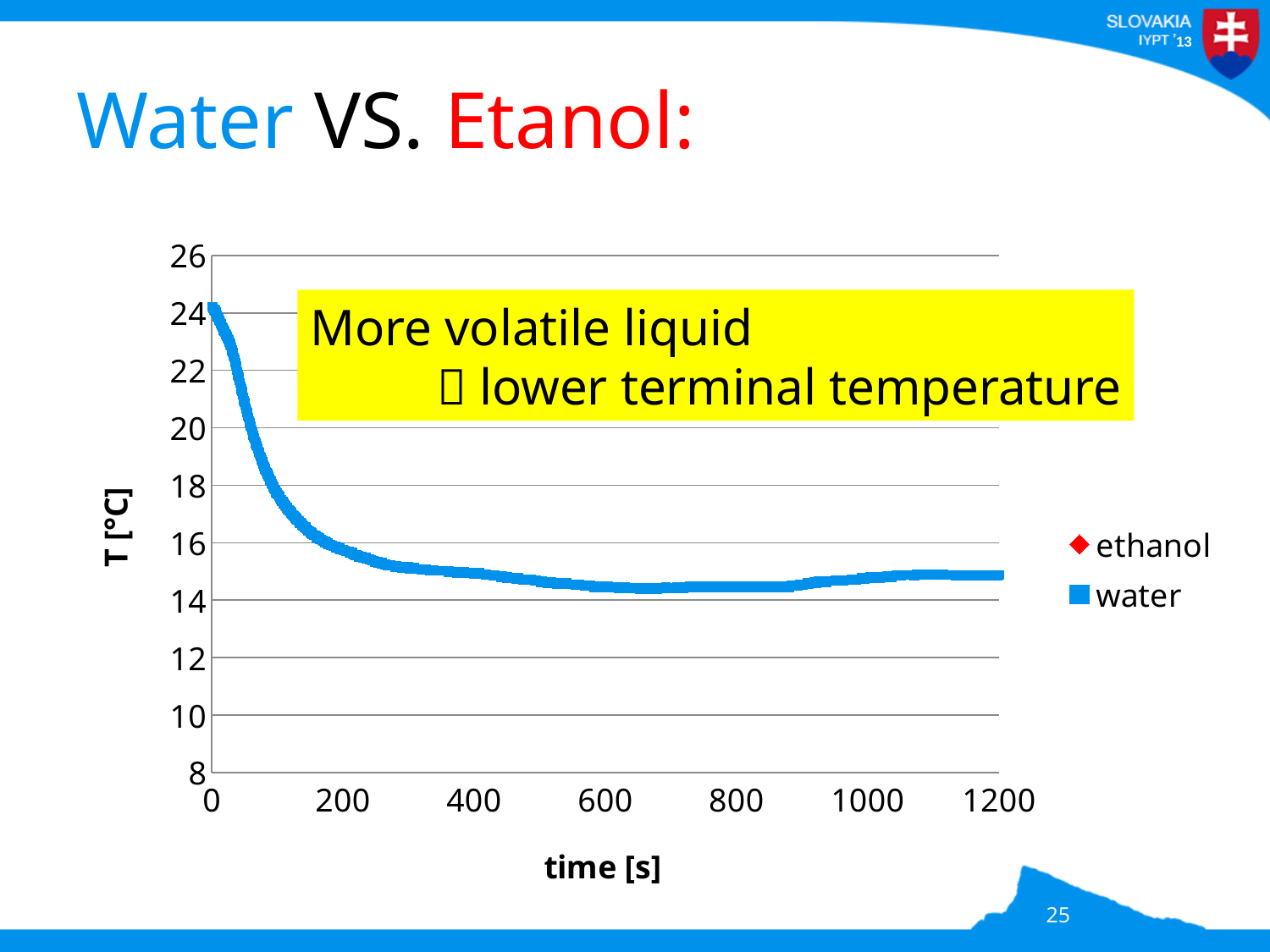
Is the water temperature at 0 s larger or smaller than at 400 s? larger At which time is the water temperature highest? 0 s How many series does the legend list? 2 Is the water temperature at 1200 s greater or less than 16? less Does the water temperature rise or fall as time increases from 0 to 600 s? falls Which two series are listed in the legend? ethanol and water Is the water temperature at 100 s greater or less than 16? greater What kind of chart is shown on the slide? scatter chart What is the label of the y axis? T [°C] Is the water temperature at time 0 s greater or less than 22? greater